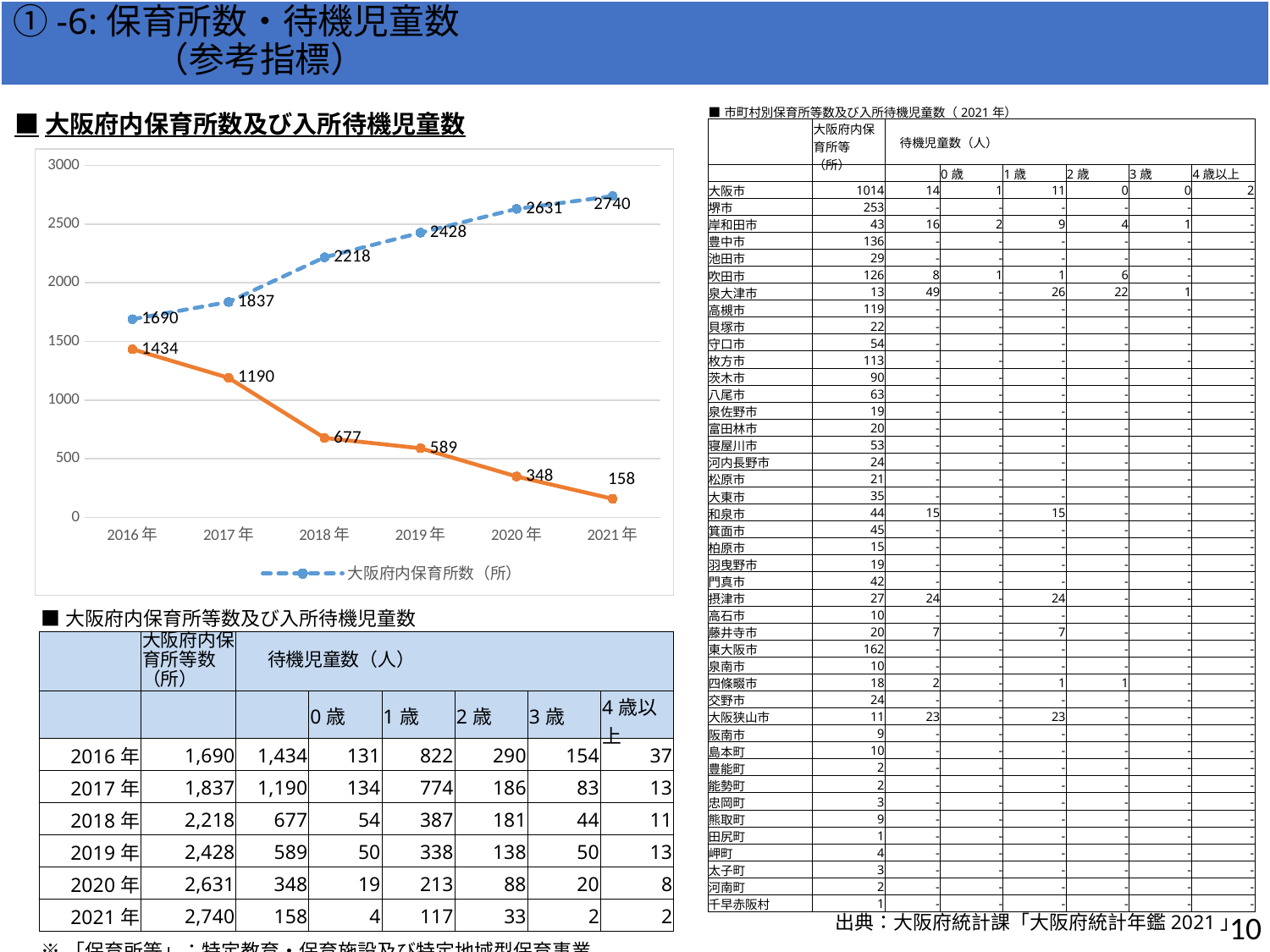
What is the legend entry shown below the chart? 大阪府内保育所数（所） What is the value of the orange line (待機児童数) for 2020年 in the chart? 348 In which year does the dashed blue line (大阪府内保育所数) reach its highest value? 2021年 By how much did 大阪府内保育所数 increase from 2016年 (1690) to 2021年 (2740)? 1050 For 2017年, which is larger: the dashed blue line value or the orange line value? The dashed blue line (1837) What is the difference between the orange line's 2016年 value (1434) and its 2021年 value (158)? 1276 In which year is the orange line (待機児童数) at its lowest value? 2021年 How many years are shown on the x axis of the chart? 6 Is the orange line's value for 2019年 greater or less than 500? greater Does the dashed blue line (大阪府内保育所数) rise or fall from 2016年 to 2021年? Rise What type of chart is used to show 大阪府内保育所数及び入所待機児童数? Line chart What is the value of 大阪府内保育所数（所） for 2018年 in the line chart? 2218